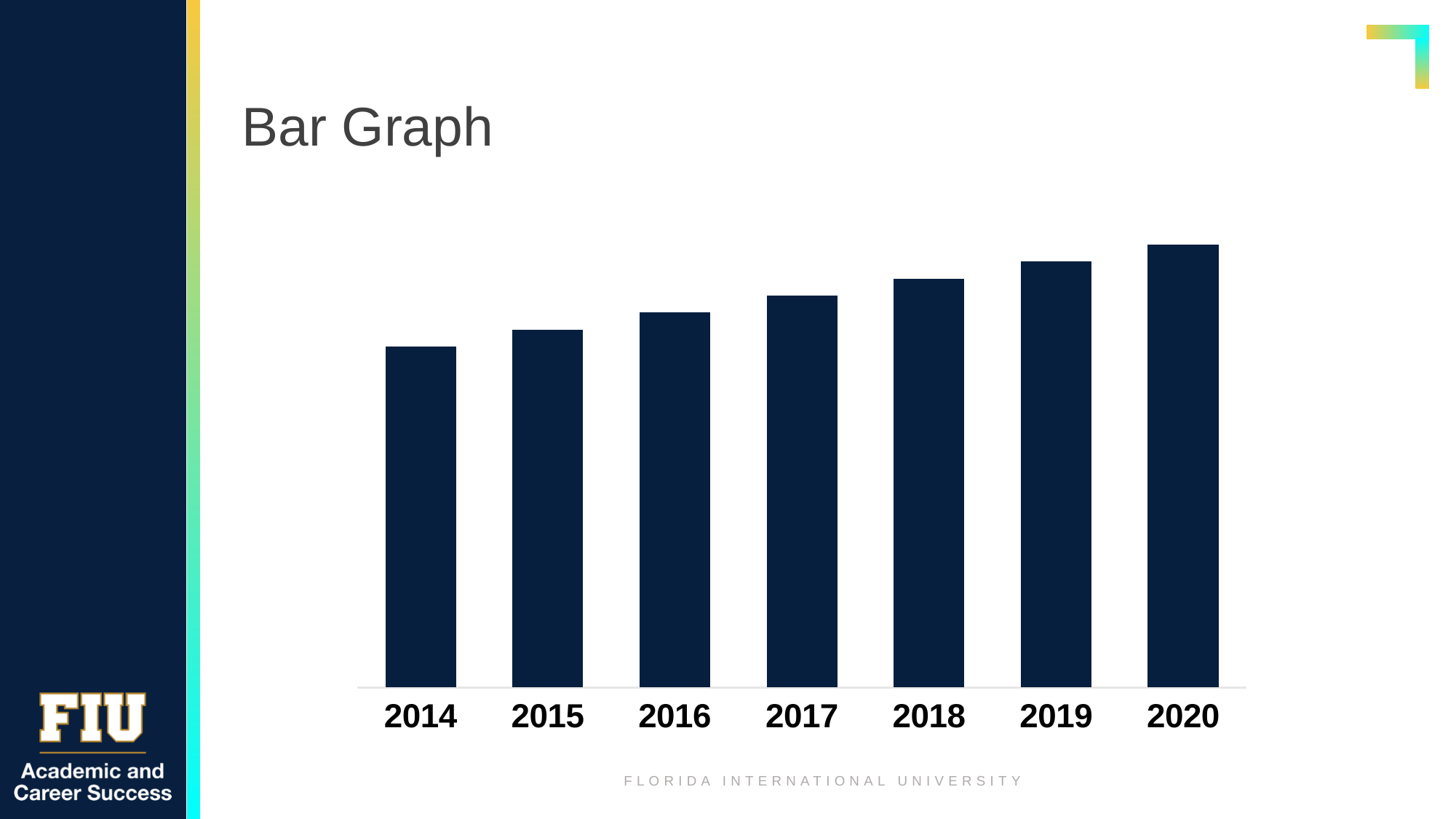
Which year has the shortest bar? 2014 What kind of chart is shown on the slide? Bar chart Do the bar heights rise or fall from 2014 to 2020? Rise What is the title of the slide containing the chart? Bar Graph What is the first year shown on the x axis? 2014 Which bar is taller, 2017 or 2018? 2018 Which year has the tallest bar? 2020 Which bar is taller, 2015 or 2014? 2015 Which bar is taller, 2016 or 2019? 2019 How many bars (years) are plotted in the chart? 7